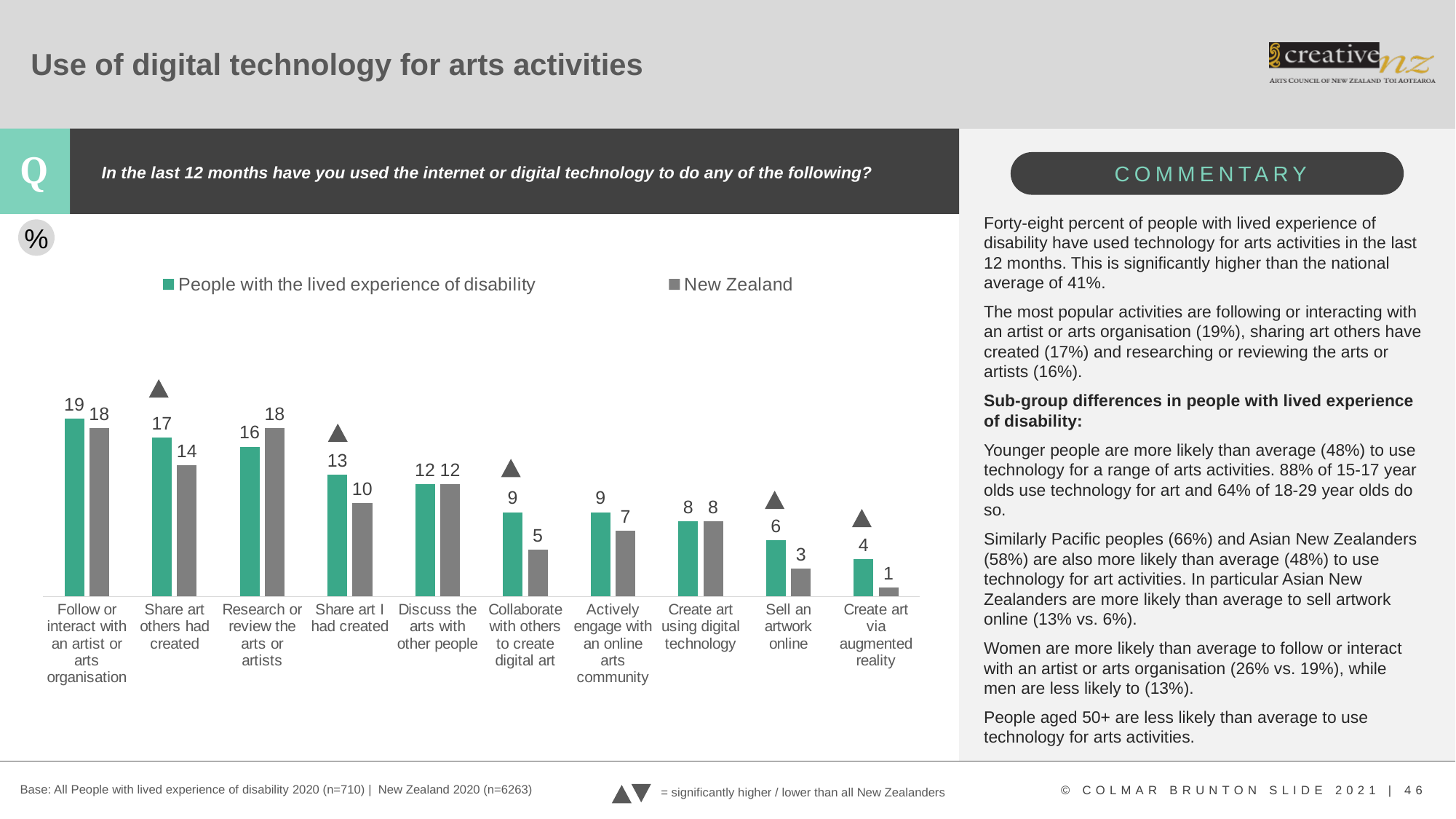
How many series does the legend list? 2 Which category has the lowest New Zealand value? Create art via augmented reality What is the difference between the two series for 'Collaborate with others to create digital art'? 4 Which series has the larger value for 'Research or review the arts or artists'? New Zealand What kind of chart is shown on the slide? Bar chart What is the value for 'Follow or interact with an artist or arts organisation' for People with the lived experience of disability? 19 Do the values for People with the lived experience of disability rise or fall from left to right along the x axis? Fall Which category has the highest value for People with the lived experience of disability? Follow or interact with an artist or arts organisation What colour are the bars for the New Zealand series? Grey What is the value for 'Sell an artwork online' for People with the lived experience of disability? 6 What is the New Zealand value for 'Share art others had created'? 14 How many categories are shown on the x axis? 10